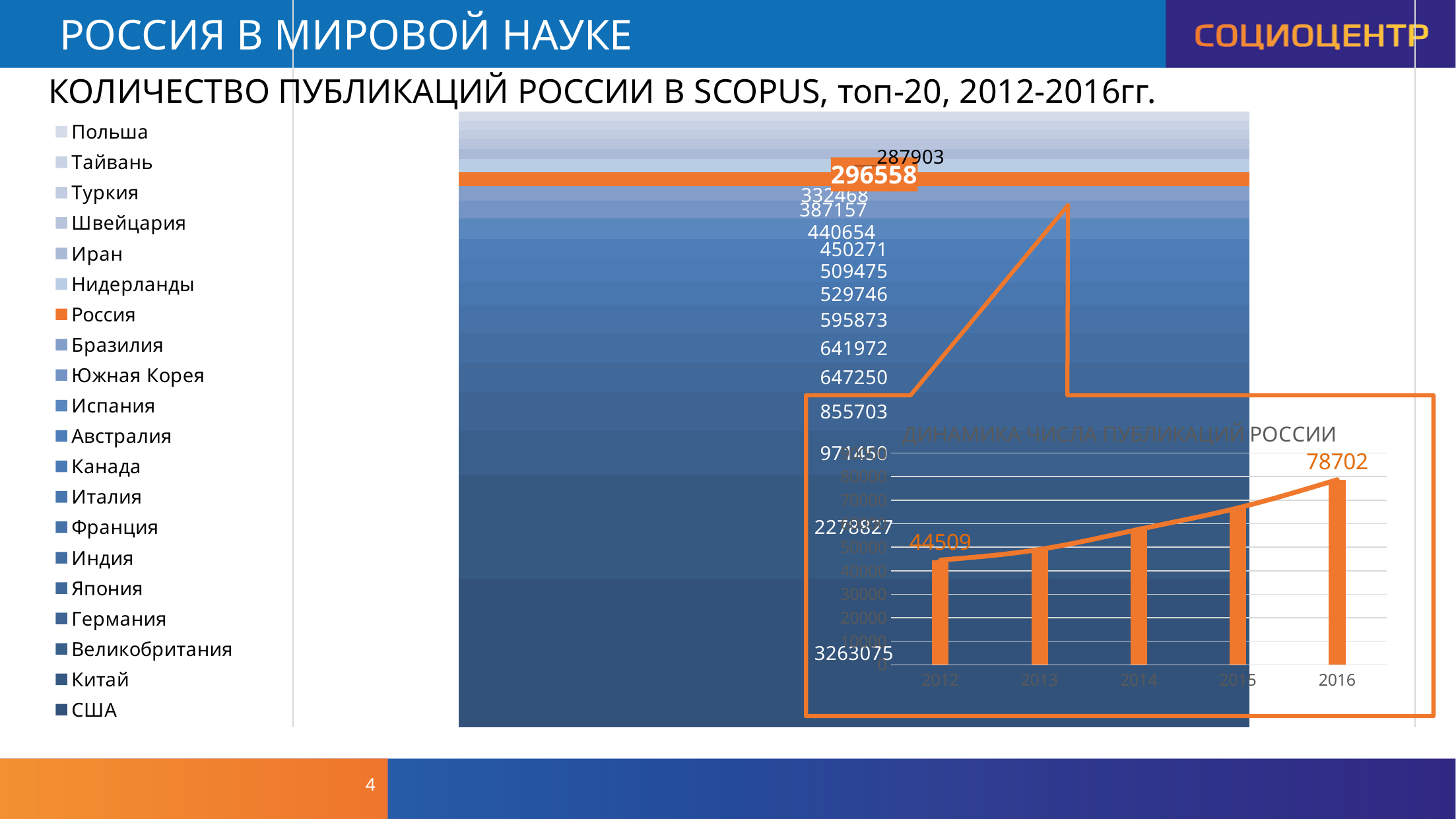
In the inset chart 'ДИНАМИКА ЧИСЛА ПУБЛИКАЦИЙ РОССИИ', what is the value for 2012? 44509 How many countries does the legend of the main chart 'КОЛИЧЕСТВО ПУБЛИКАЦИЙ РОССИИ В SCOPUS, топ-20, 2012-2016гг.' list? 20 In the inset chart 'ДИНАМИКА ЧИСЛА ПУБЛИКАЦИЙ РОССИИ', which year has the highest value? 2016 In the inset chart 'ДИНАМИКА ЧИСЛА ПУБЛИКАЦИЙ РОССИИ', is the value for 2015 greater or less than 60000? greater In the main stacked chart 'КОЛИЧЕСТВО ПУБЛИКАЦИЙ РОССИИ В SCOPUS, топ-20, 2012-2016гг.', what value is labelled on the orange segment for Россия? 296558 In the inset chart 'ДИНАМИКА ЧИСЛА ПУБЛИКАЦИЙ РОССИИ', how many years are shown on the x axis? 5 In the inset chart 'ДИНАМИКА ЧИСЛА ПУБЛИКАЦИЙ РОССИИ', is the value for 2014 greater or less than 50000? greater In the inset chart 'ДИНАМИКА ЧИСЛА ПУБЛИКАЦИЙ РОССИИ', which year has the lowest value? 2012 In the inset chart 'ДИНАМИКА ЧИСЛА ПУБЛИКАЦИЙ РОССИИ', what is the value for 2016? 78702 In the inset chart 'ДИНАМИКА ЧИСЛА ПУБЛИКАЦИЙ РОССИИ', what is the difference between the 2016 and 2012 values? 34193 What kind of chart is the inset chart 'ДИНАМИКА ЧИСЛА ПУБЛИКАЦИЙ РОССИИ'? combination bar and line chart In the inset chart 'ДИНАМИКА ЧИСЛА ПУБЛИКАЦИЙ РОССИИ', do the values rise or fall from 2012 to 2016? rise